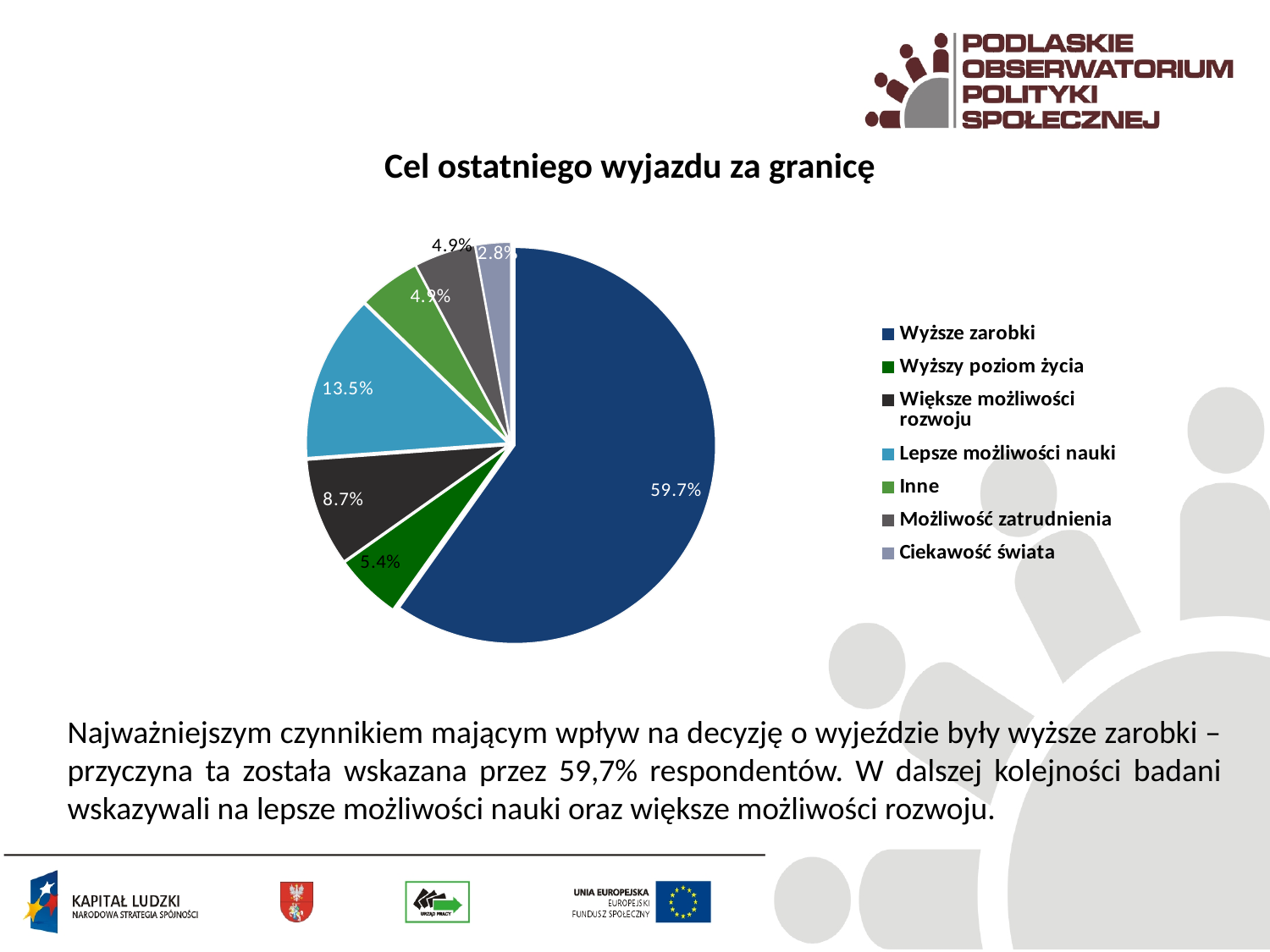
How many categories does the legend list? 7 What is the title of the chart? Cel ostatniego wyjazdu za granicę Which category has the smallest slice of the pie? Ciekawość świata What is the value for Lepsze możliwości nauki? 13.5% Which is larger, Większe możliwości rozwoju or Wyższy poziom życia? Większe możliwości rozwoju What type of chart is shown on the slide? pie chart What is the value for Większe możliwości rozwoju? 8.7% Which category has the largest slice of the pie? Wyższe zarobki What share of the pie does Wyższe zarobki have? 59.7% What is the value for Wyższy poziom życia? 5.4% What is the difference between the values for Wyższe zarobki and Lepsze możliwości nauki? 46.2% What is the value for Ciekawość świata? 2.8%